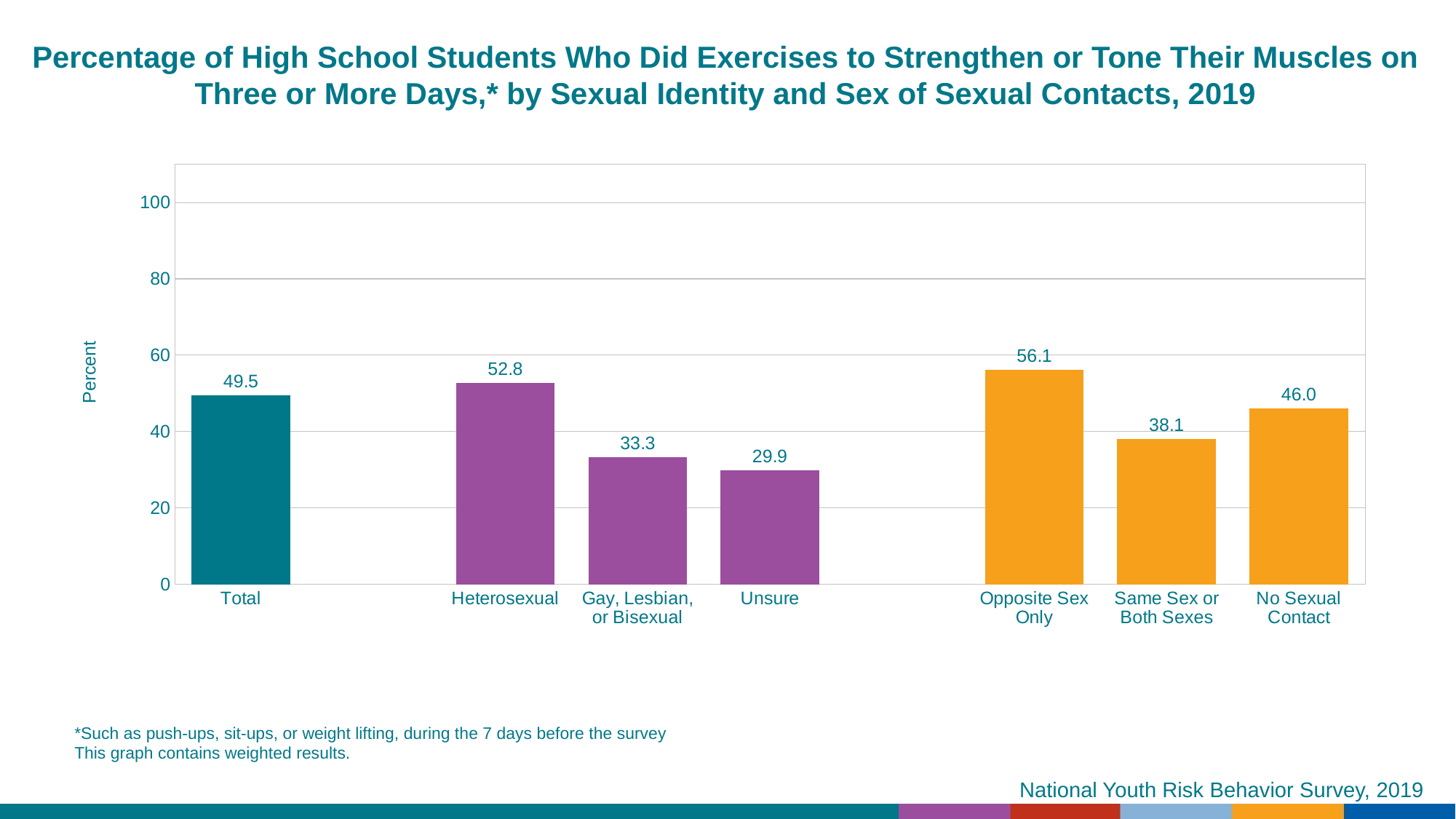
What is the difference between the values for Heterosexual and Unsure? 22.9 Which is larger, the value for Total or the value for No Sexual Contact? Total What is the value for students with No Sexual Contact? 46.0 What kind of chart is this? Bar chart Which category has the highest value? Opposite Sex Only What is the value for Heterosexual students? 52.8 Which category has the lowest value? Unsure What is the label of the y axis? Percent What is the value for Total? 49.5 How many bars are shown in the chart? 7 What is the value for Gay, Lesbian, or Bisexual students? 33.3 What is the difference between the values for Opposite Sex Only and Same Sex or Both Sexes? 18.0